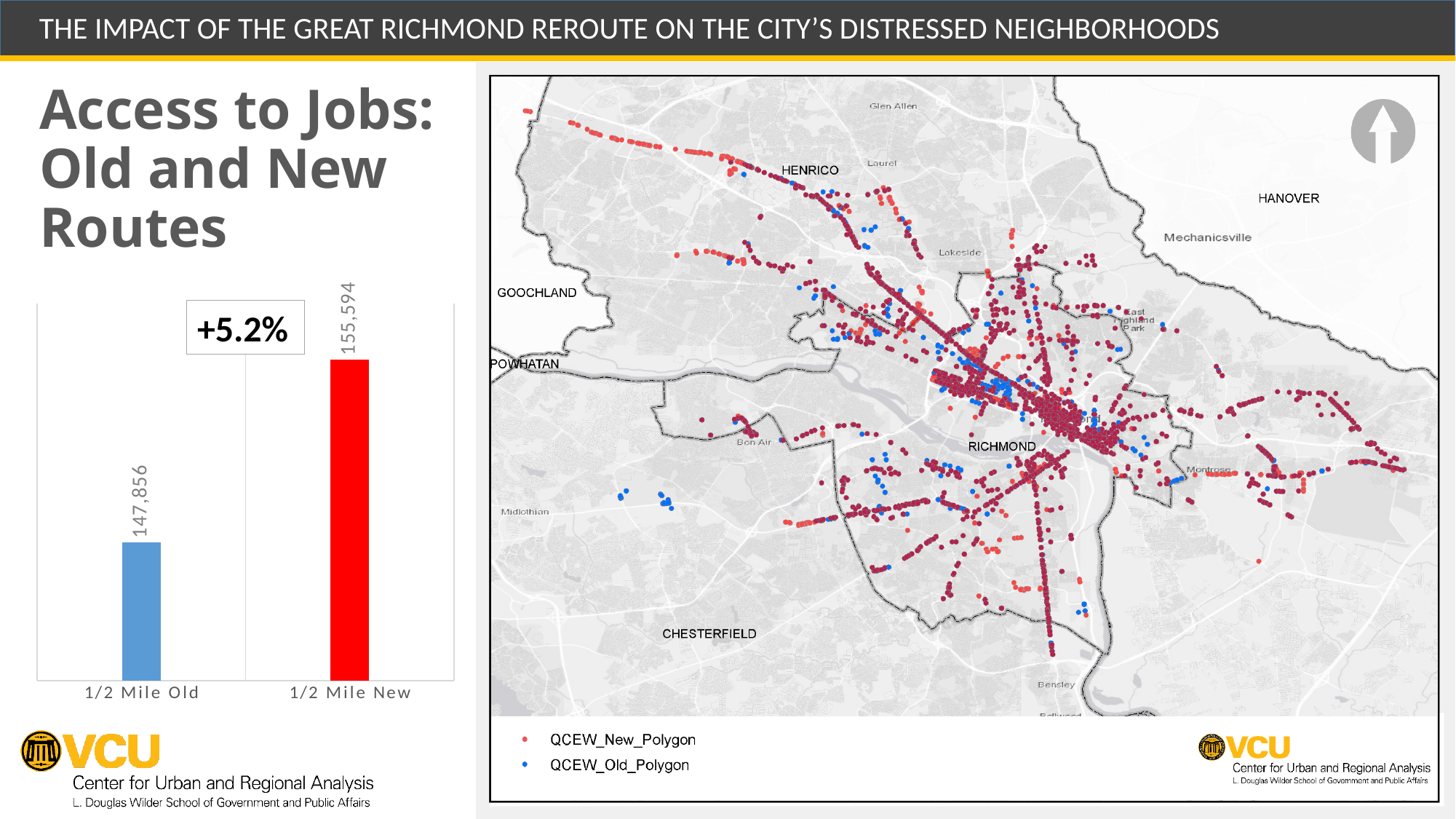
In the bar chart, what is the value for 1/2 Mile Old? 147,856 How many bars are shown in the bar chart? 2 What percentage change is annotated on the bar chart? +5.2% In the bar chart, what is the value for 1/2 Mile New? 155,594 What kind of chart is shown on the left side of the slide? bar chart In the bar chart, what colour is the 1/2 Mile New bar? red In the bar chart, what is the difference between the 1/2 Mile New and 1/2 Mile Old values? 7,738 In the bar chart, which category has the higher value? 1/2 Mile New In the bar chart, is the value for 1/2 Mile Old larger or smaller than the value for 1/2 Mile New? smaller Do the values in the bar chart rise or fall from 1/2 Mile Old to 1/2 Mile New? rise In the bar chart, which category has the lower value? 1/2 Mile Old